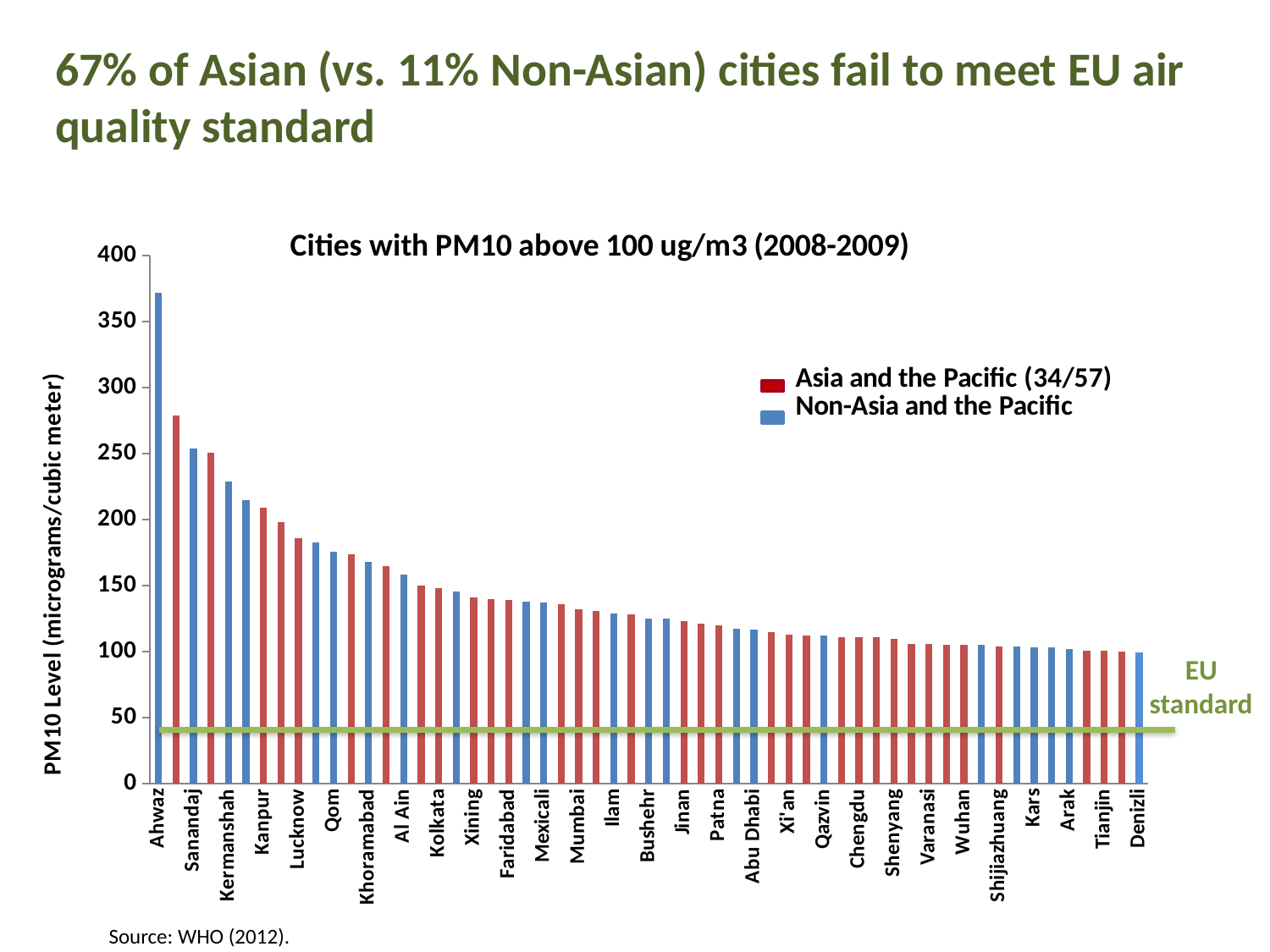
How many series does the legend list? 2 What does the green horizontal line on the chart represent? EU standard What is the title of the chart? Cities with PM10 above 100 ug/m3 (2008-2009) Do the PM10 levels rise or fall moving from left to right across the cities? Fall Which city has a higher PM10 level, Sanandaj or Kanpur? Sanandaj Which labelled city has the lowest PM10 level in the chart? Denizli Is the PM10 level for Ahwaz greater or less than 350? greater Is the PM10 level for Lucknow greater or less than 200? less Which city has the highest PM10 level in the chart? Ahwaz Is the PM10 level for Kanpur greater or less than 200? greater What kind of chart is shown on the slide? Bar chart